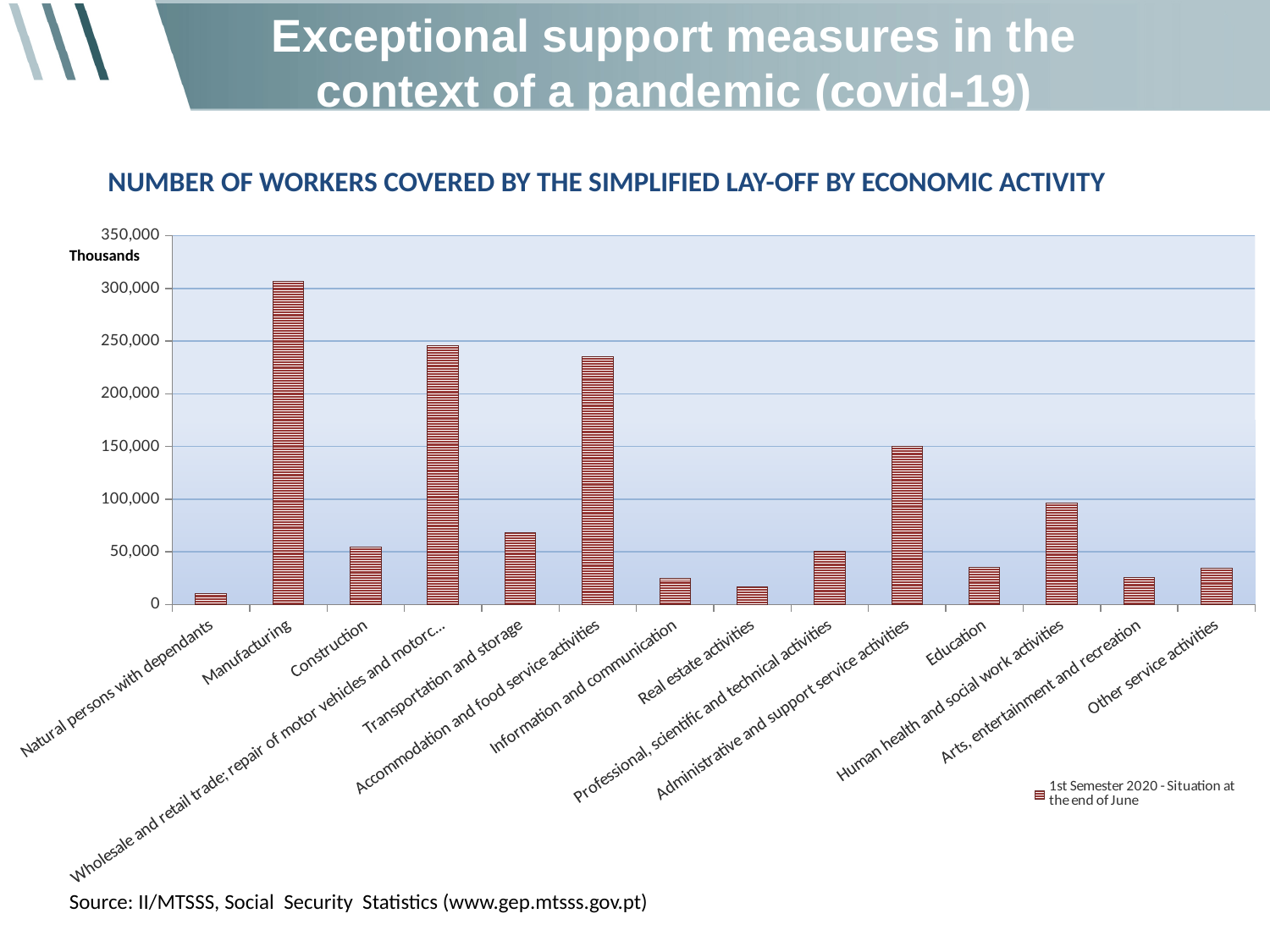
What kind of chart is shown on the slide? bar chart What is the legend entry for the series shown in the chart? 1st Semester 2020 - Situation at the end of June Which is larger, the value for Construction or the value for Transportation and storage? Transportation and storage Which economic activity has the lowest number of workers covered by the simplified lay-off? Natural persons with dependants Which economic activity has the highest number of workers covered by the simplified lay-off? Manufacturing Which is larger, the value for Administrative and support service activities or the value for Human health and social work activities? Administrative and support service activities Is the value for Administrative and support service activities greater or less than 100,000? greater Is the value for Transportation and storage greater or less than 50,000? greater How many economic activity categories are shown on the x axis? 14 Is the value for Accommodation and food service activities greater or less than 200,000? greater